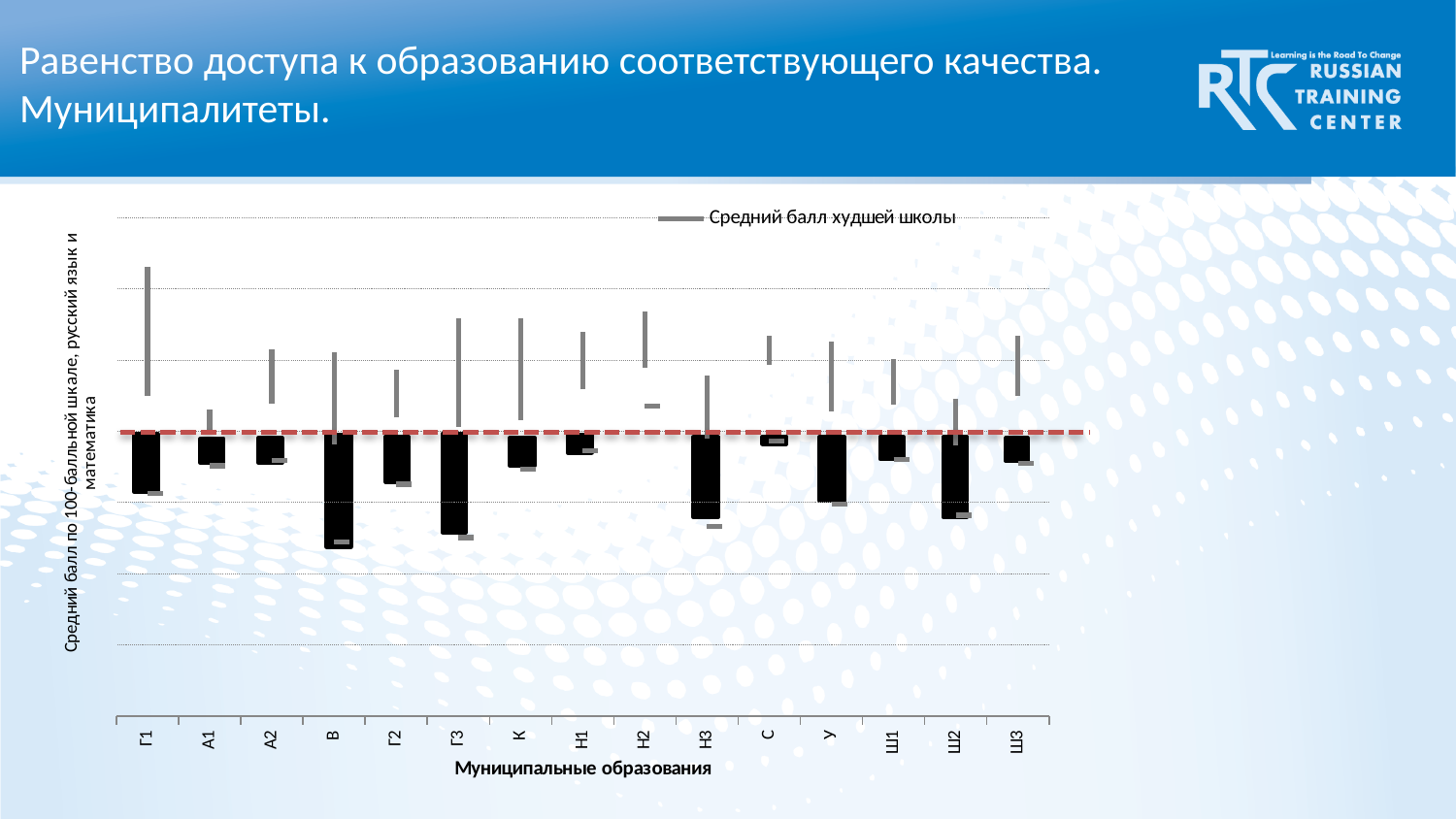
What is the title of the x axis of the chart? Муниципальные образования Which municipality has the smallest black bar below the dashed red line? С What kind of chart is shown on the slide? Bar chart Which black bar extends further below the dashed red line, Г3 or Н1? Г3 Which municipality has the tallest grey bar above the dashed red line? Г1 What is the legend entry shown on the chart? Средний балл худшей школы Which black bar extends further below the dashed red line, В or А1? В How many series does the chart's legend list? 1 How many municipalities (categories) are shown on the x axis of the chart? 15 What is the first category label on the x axis of the chart? Г1 Which municipality has the black bar extending furthest below the dashed red line? В Which grey bar extends higher above the dashed red line, Н2 or Н3? Н2